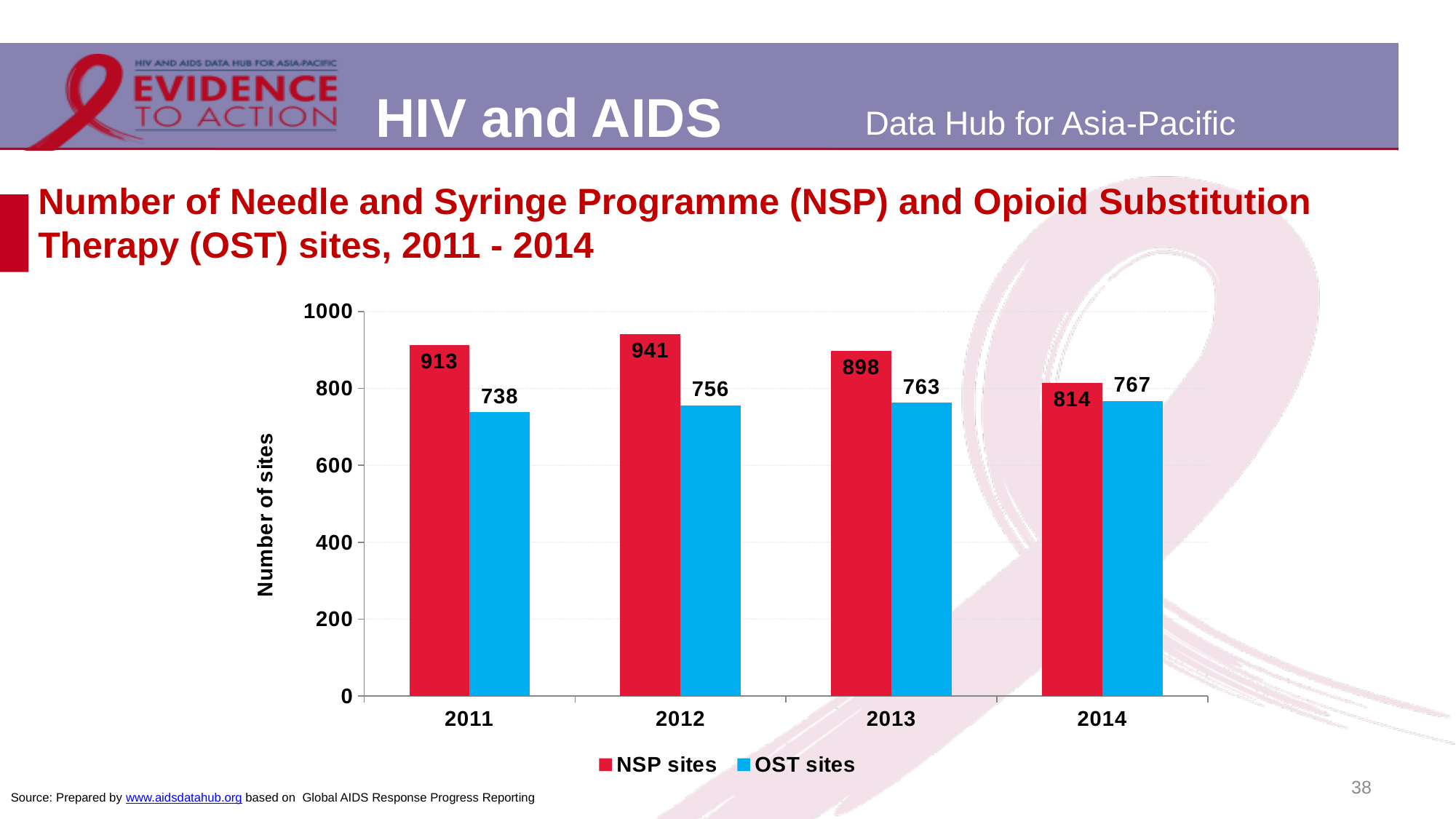
How many series does the legend list? 2 Is the number of NSP sites in 2013 greater or less than 800? greater How many NSP sites were there in 2012? 941 In which year was the number of NSP sites highest? 2012 How many years are shown on the x axis? 4 What kind of chart is shown on the slide? Bar chart What is the label of the y axis? Number of sites Which was larger in 2014, the number of NSP sites or the number of OST sites? NSP sites How many OST sites were there in 2014? 767 In which year was the number of OST sites lowest? 2011 What is the difference between the number of NSP sites and OST sites in 2011? 175 Does the number of OST sites rise or fall from 2011 to 2014? Rise